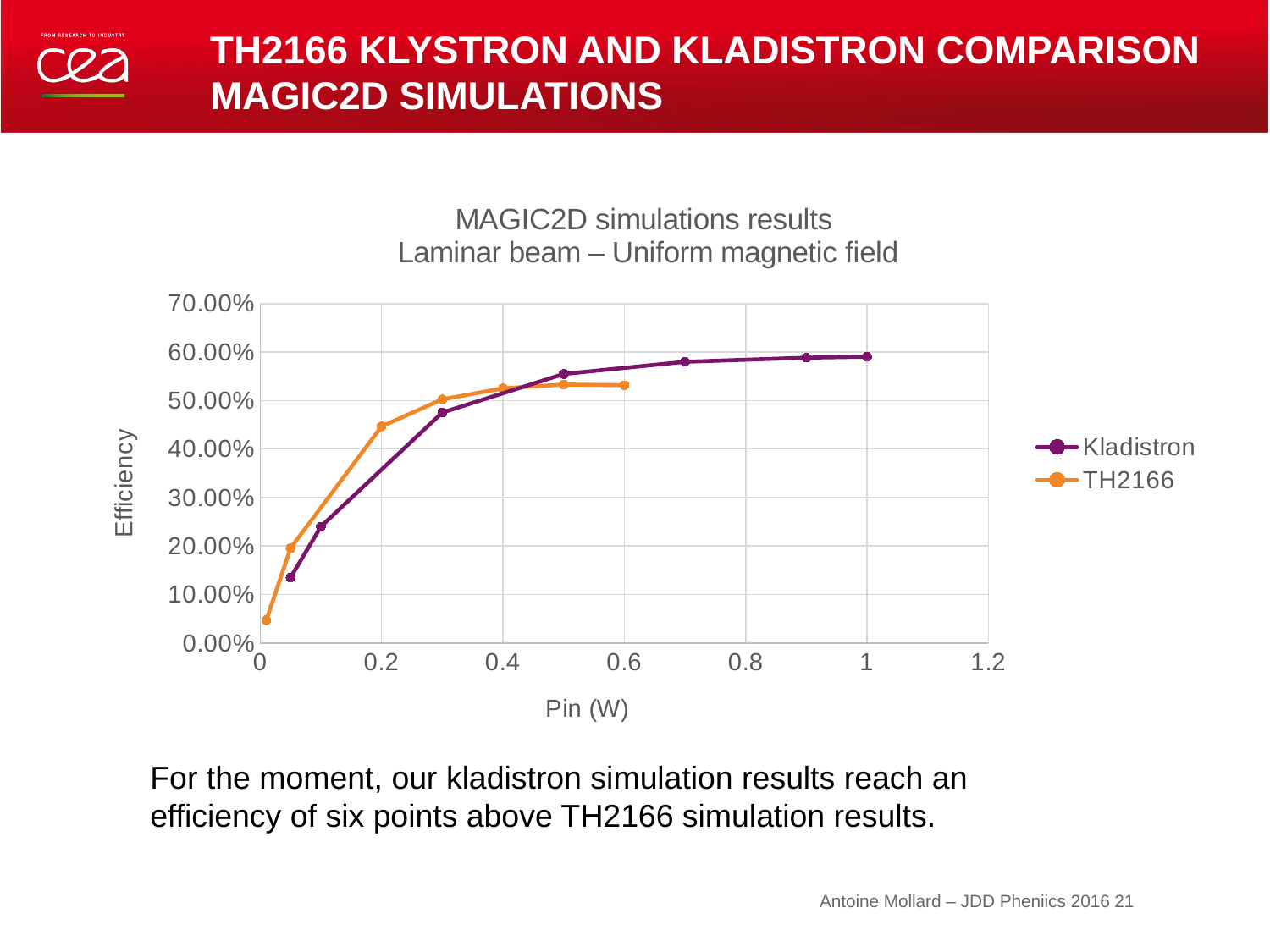
Is the TH2166 efficiency at Pin = 0.2 W greater or less than 40.00%? greater What kind of chart is shown on the slide? Line chart Which series reaches the highest efficiency on the chart? Kladistron How many series does the legend list? 2 Is the Kladistron efficiency at Pin = 1 W greater or less than 50.00%? greater What are the two series named in the legend? Kladistron and TH2166 Does the efficiency of the Kladistron series rise or fall as Pin increases? Rise How many data points are plotted for the TH2166 series? 7 At Pin = 0.05 W, which series has the higher efficiency, Kladistron or TH2166? TH2166 What is the label of the x axis? Pin (W) Which series extends to the higher Pin value on the x axis? Kladistron Is the Kladistron efficiency at Pin = 0.1 W greater or less than 30.00%? less